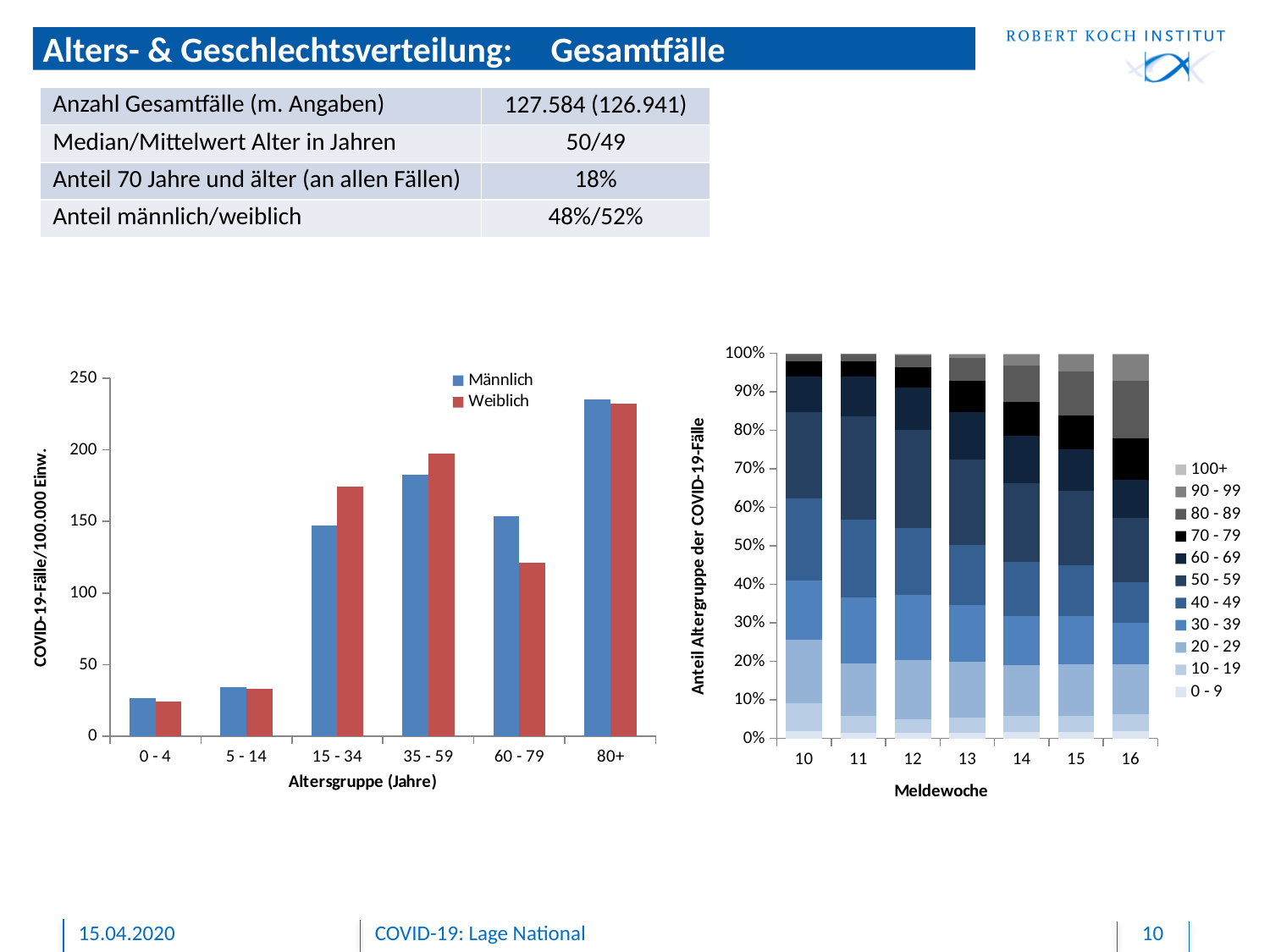
What kind of chart is the right chart (Anteil Altergruppe der COVID-19-Fälle by Meldewoche)? stacked bar chart In the right chart, how many Meldewochen are shown on the x axis? 7 In the left chart, for the age group 15 - 34, which is larger: Männlich or Weiblich? Weiblich In the left chart, is the Männlich value for the age group 35 - 59 greater or less than 150? greater In the right chart, how many age groups does the legend list? 11 In the left chart, how many series does the legend list? 2 In the left chart, how many age groups are shown on the x axis? 6 What kind of chart is the left chart (COVID-19-Fälle/100.000 Einw. by Altersgruppe)? bar chart In the left chart, for the age group 60 - 79, which is larger: Männlich or Weiblich? Männlich In the left chart, is the Weiblich value for the age group 60 - 79 greater or less than 150? less In the left chart, which age group has the highest value for Männlich? 80+ In the left chart, which age group has the lowest value for Weiblich? 0 - 4